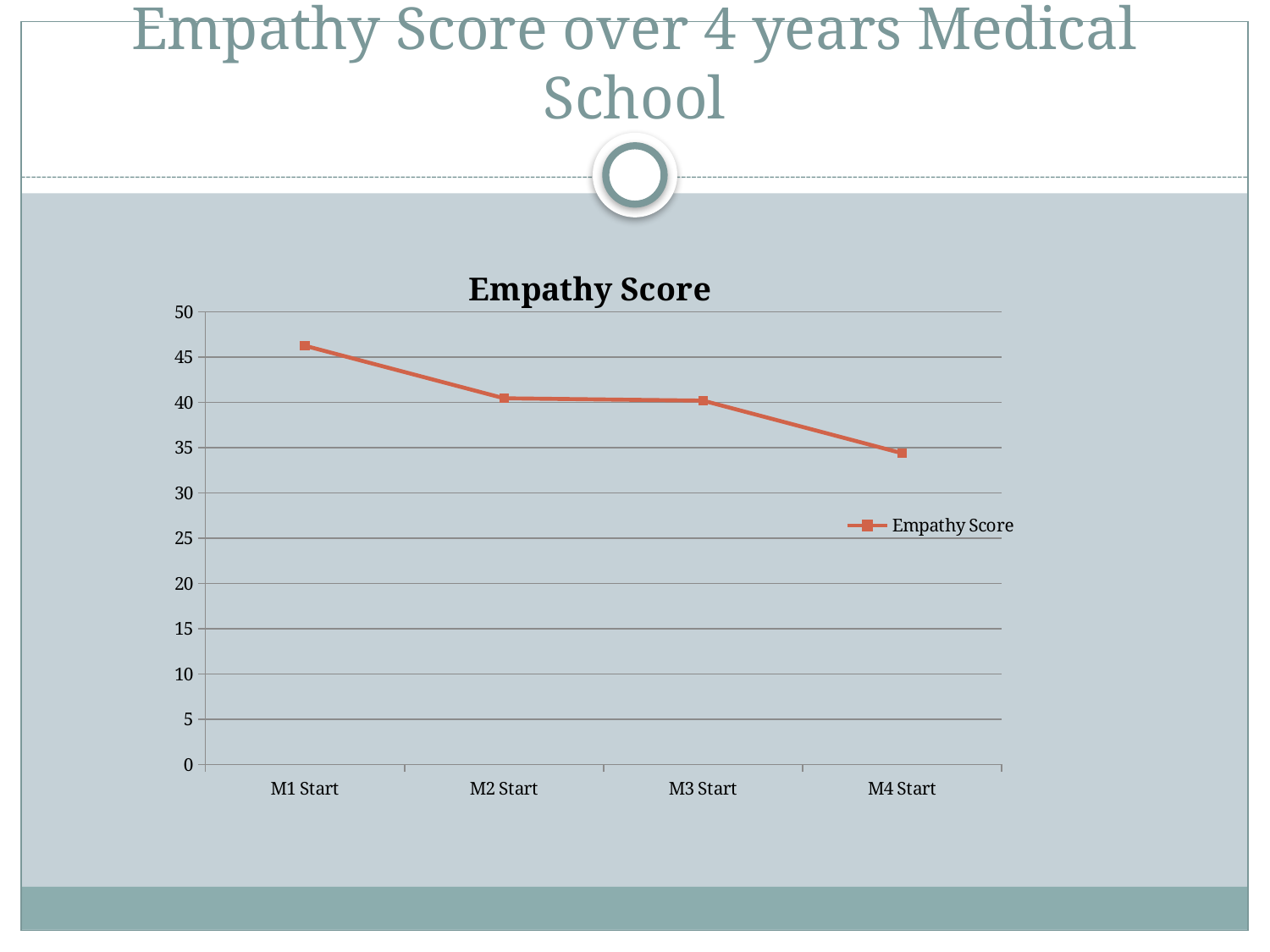
How many series does the legend of the Empathy Score chart list? 1 Which is larger, the Empathy Score at M1 Start or at M4 Start? M1 Start Is the Empathy Score at M4 Start greater or less than 40? less Which point has the lowest Empathy Score? M4 Start Is the Empathy Score at M1 Start greater or less than 45? greater What kind of chart is shown on the slide? line chart Do the Empathy Score values rise or fall from M1 Start to M4 Start? fall Is the Empathy Score at M3 Start greater or less than 45? less What is the title of the chart? Empathy Score Which point has the highest Empathy Score? M1 Start What is the label of the series shown in the legend? Empathy Score How many points are plotted along the x axis of the Empathy Score chart? 4